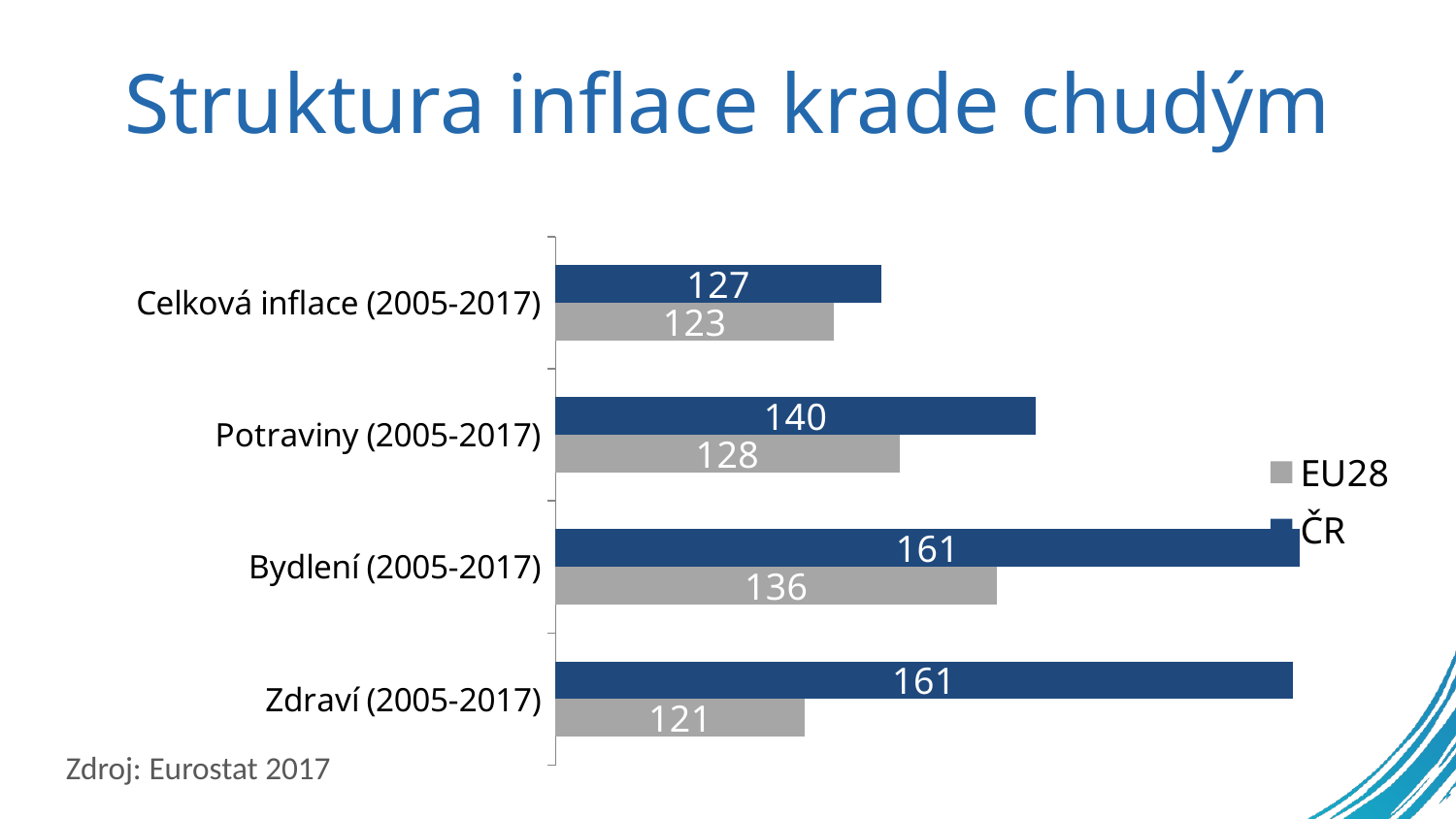
Which category has the highest EU28 value? Bydlení (2005-2017) How many series does the legend list? 2 What is the EU28 value for Bydlení (2005-2017)? 136 How many categories are shown on the chart? 4 What is the difference between the ČR and EU28 values for Bydlení (2005-2017)? 25 What is the ČR value for Celková inflace (2005-2017)? 127 Which category has the lowest EU28 value? Zdraví (2005-2017) What is the EU28 value for Zdraví (2005-2017)? 121 What is the difference between the ČR and EU28 values for Zdraví (2005-2017)? 40 What is the ČR value for Potraviny (2005-2017)? 140 Which category has the lowest ČR value? Celková inflace (2005-2017) Which is larger for Potraviny (2005-2017), the ČR value or the EU28 value? ČR